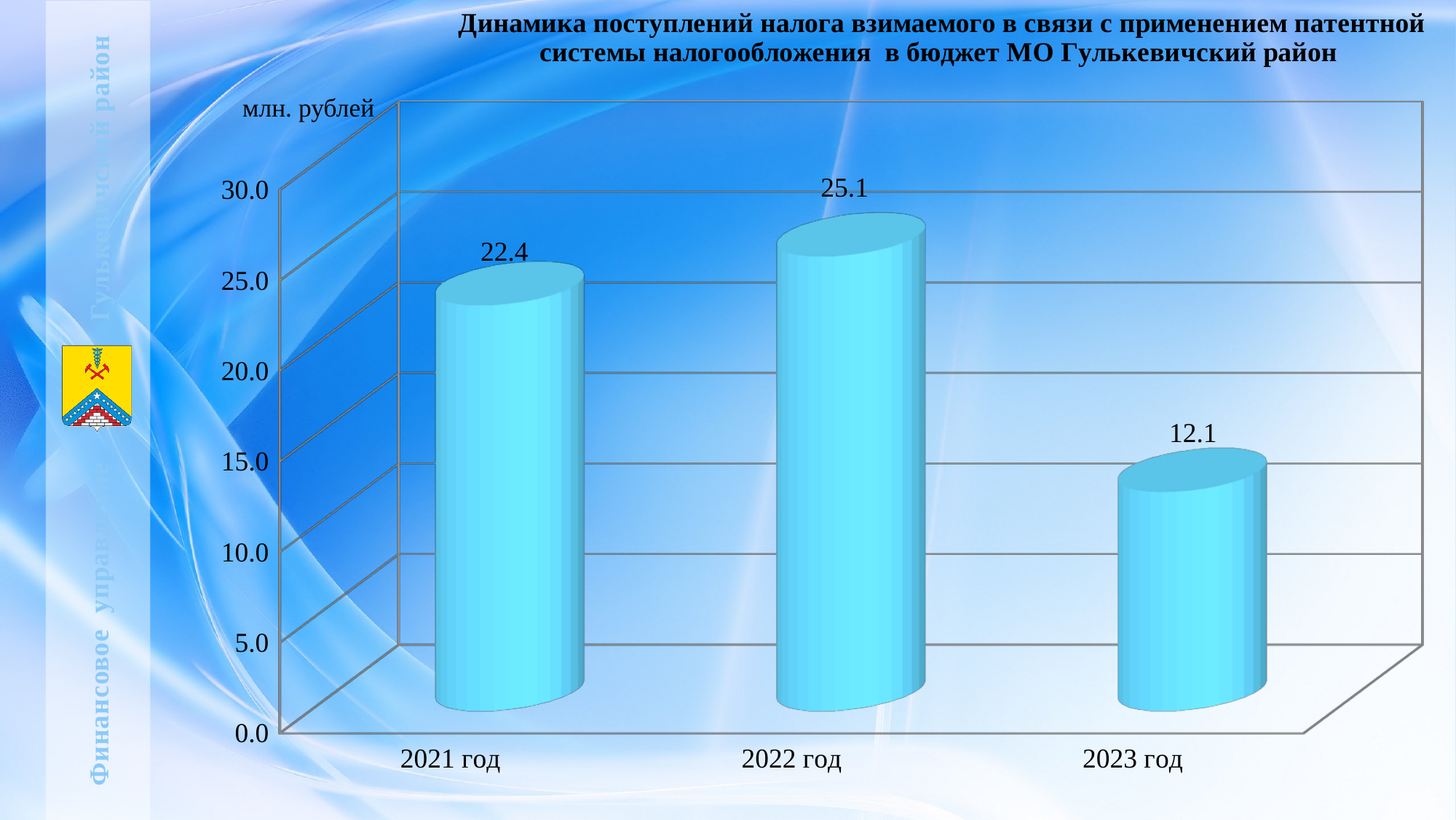
What is the value for 2021 год? 22.4 What is the value for 2023 год? 12.1 Which year has the lowest value? 2023 год Is the value for 2023 год greater or less than 15.0? less What kind of chart is shown on the slide? bar chart What unit is shown on the vertical axis of the chart? млн. рублей What is the difference between the values for 2022 год and 2023 год? 13.0 Which is larger, the value for 2021 год or the value for 2023 год? 2021 год How many years are shown on the chart? 3 Which year has the highest value? 2022 год What is the difference between the values for 2022 год and 2021 год? 2.7 What is the value for 2022 год? 25.1